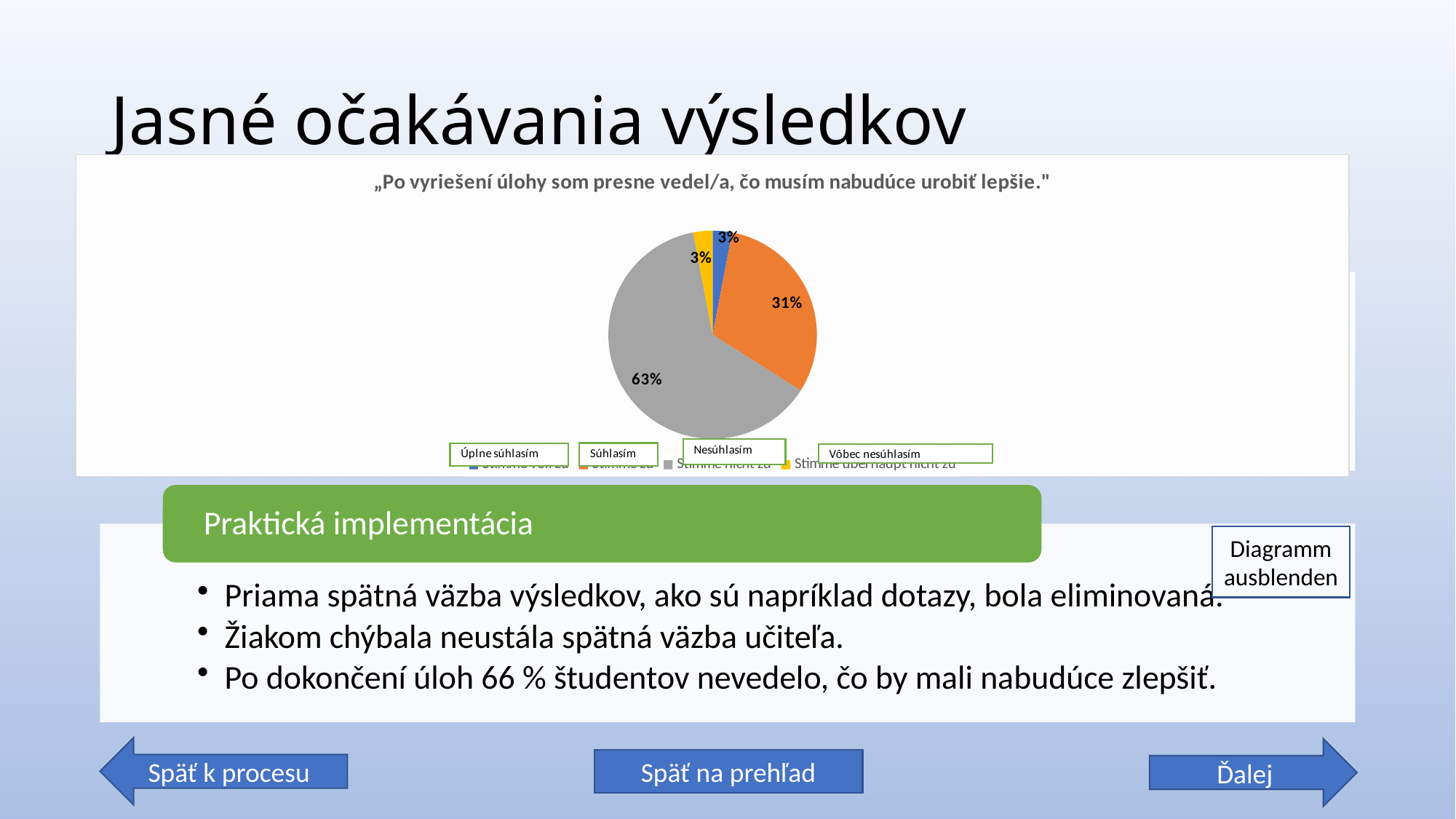
What kind of chart is shown on the slide? pie chart How many slices does the pie chart have? 4 What percentage of the pie is labelled for the "Úplne súhlasím" slice? 3% What percentage of the pie is labelled for the "Súhlasím" slice? 31% What is the title of the pie chart? „Po vyriešení úlohy som presne vedel/a, čo musím nabudúce urobiť lepšie." What is the difference in percentage points between the "Nesúhlasím" slice and the "Súhlasím" slice? 32 How many entries does the chart legend list? 4 Which slice is larger, "Súhlasím" or "Nesúhlasím"? Nesúhlasím Which category has the largest slice of the pie? Nesúhlasím What colour is the "Nesúhlasím" slice of the pie? grey What percentage of the pie is labelled for the "Vôbec nesúhlasím" slice? 3% What percentage of the pie is labelled for the "Nesúhlasím" slice? 63%